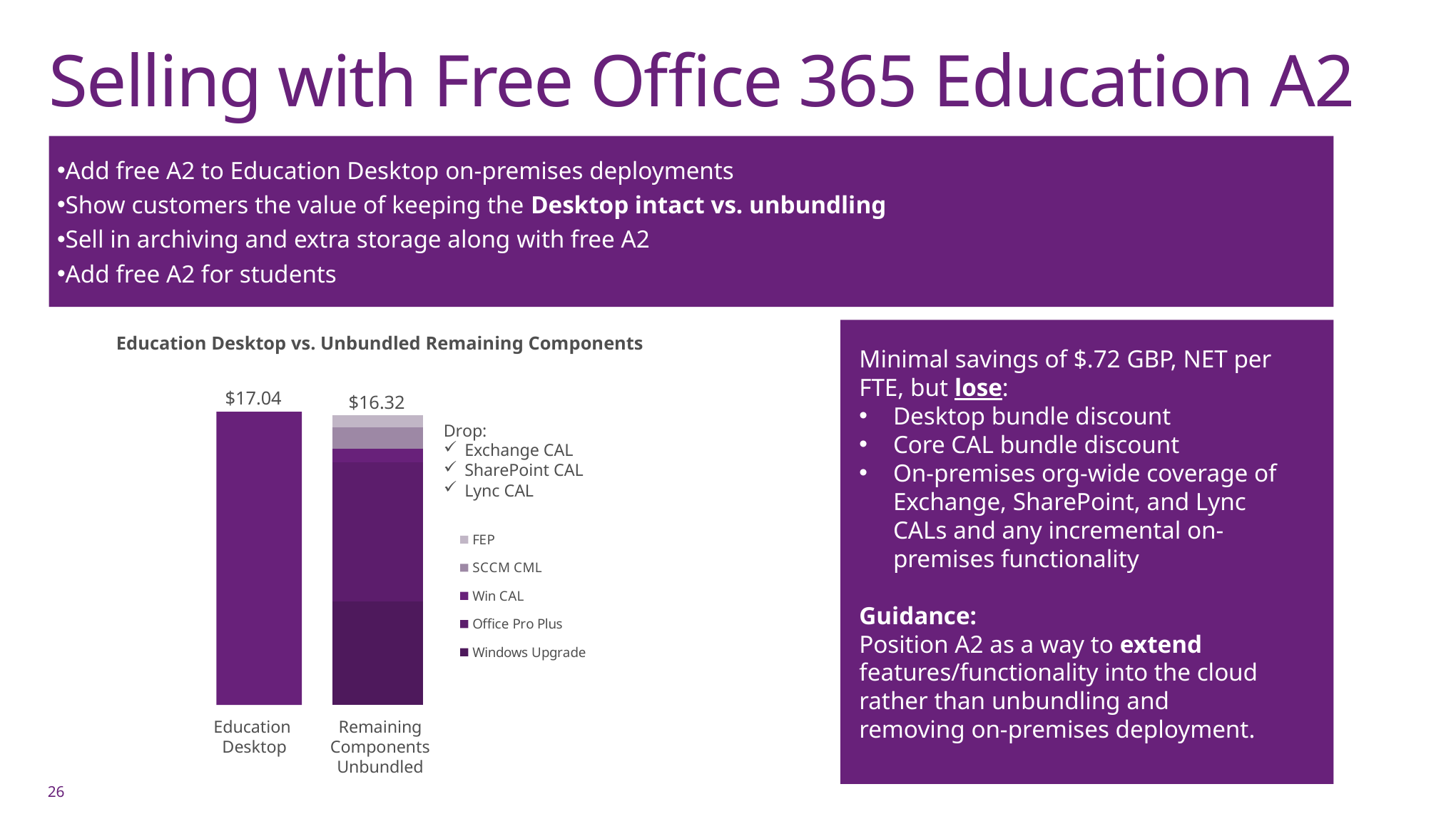
Which bar has the higher value, Education Desktop or Remaining Components Unbundled? Education Desktop What kind of chart is shown on the slide? Stacked bar chart How many series does the chart legend list? 5 Which legend entry is listed last (at the bottom) in the chart legend? Windows Upgrade What is the difference between the Education Desktop value and the Remaining Components Unbundled value? $0.72 What is the value shown for the Education Desktop bar? $17.04 Which category has the highest total value in the chart? Education Desktop What is the title of the chart on the slide? Education Desktop vs. Unbundled Remaining Components How many bars (categories) are plotted in the chart? 2 What is the total of the stacked Remaining Components Unbundled bar? $16.32 Which category has the lowest total value in the chart? Remaining Components Unbundled What is the total value shown for the Remaining Components Unbundled bar? $16.32